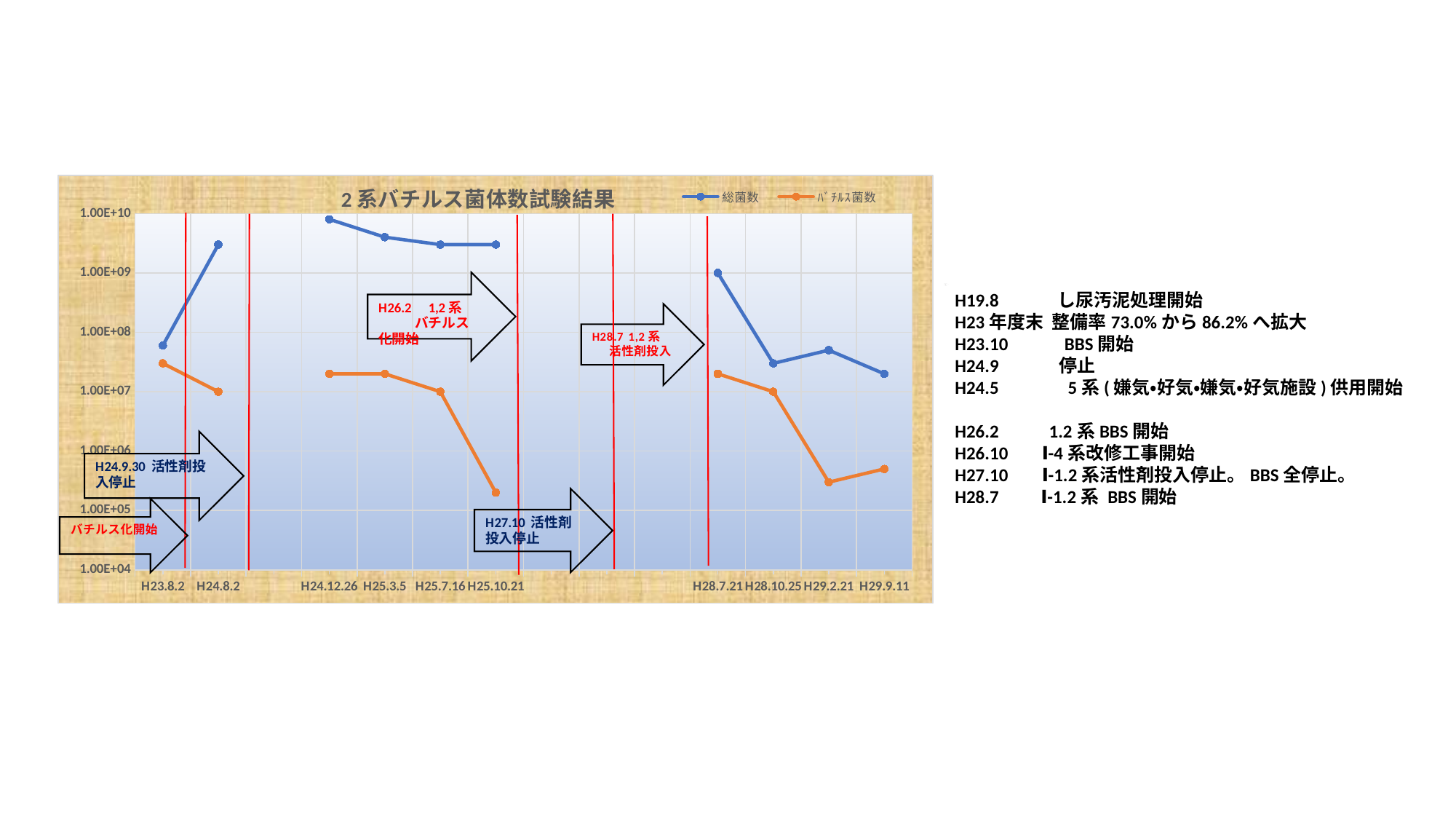
What kind of chart is shown on the slide? line chart How many series does the chart legend list? 2 Is the 総菌数 value at H24.12.26 greater or less than 1.00E+09? greater Is the 総菌数 value at H23.8.2 greater or less than 1.00E+08? less How many dates are labelled on the x axis? 10 Is the バチルス菌数 value at H25.10.21 greater or less than 1.00E+06? less What is the title of the chart? 2系バチルス菌体数試験結果 Which series is drawn in orange? バチルス菌数 Does バチルス菌数 rise or fall from H25.3.5 to H25.10.21? fall At H25.10.21, which is larger, 総菌数 or バチルス菌数? 総菌数 At which date is 総菌数 highest? H24.12.26